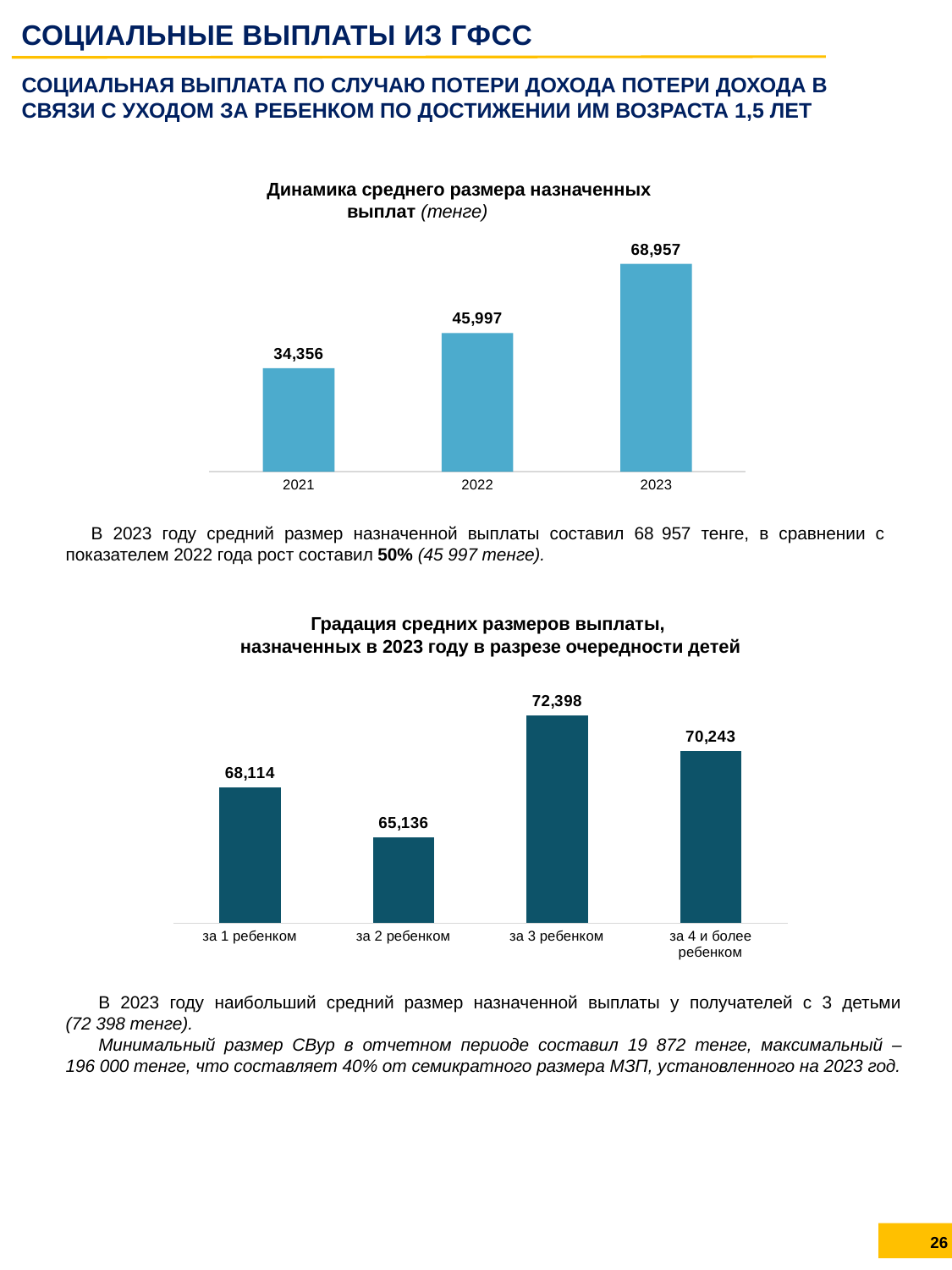
In the bottom chart 'Градация средних размеров выплаты', what is the difference between 'за 3 ребенком' and 'за 2 ребенком'? 7,262 In the bottom chart 'Градация средних размеров выплаты', which category has the highest value? за 3 ребенком In the top chart 'Динамика среднего размера назначенных выплат', what is the value for 2021? 34,356 In the top chart 'Динамика среднего размера назначенных выплат', what is the value for 2022? 45,997 In the bottom chart 'Градация средних размеров выплаты', what is the value for 'за 4 и более ребенком'? 70,243 In the top chart 'Динамика среднего размера назначенных выплат', how many years are shown? 3 In the bottom chart 'Градация средних размеров выплаты', what is the value for 'за 2 ребенком'? 65,136 In the top chart 'Динамика среднего размера назначенных выплат', what is the difference between the 2023 and 2022 values? 22,960 In the top chart 'Динамика среднего размера назначенных выплат', do the values rise or fall from 2021 to 2023? rise In the top chart 'Динамика среднего размера назначенных выплат', which year has the highest value? 2023 What type of chart is the bottom chart 'Градация средних размеров выплаты'? bar chart In the bottom chart 'Градация средних размеров выплаты', which category has the lowest value? за 2 ребенком